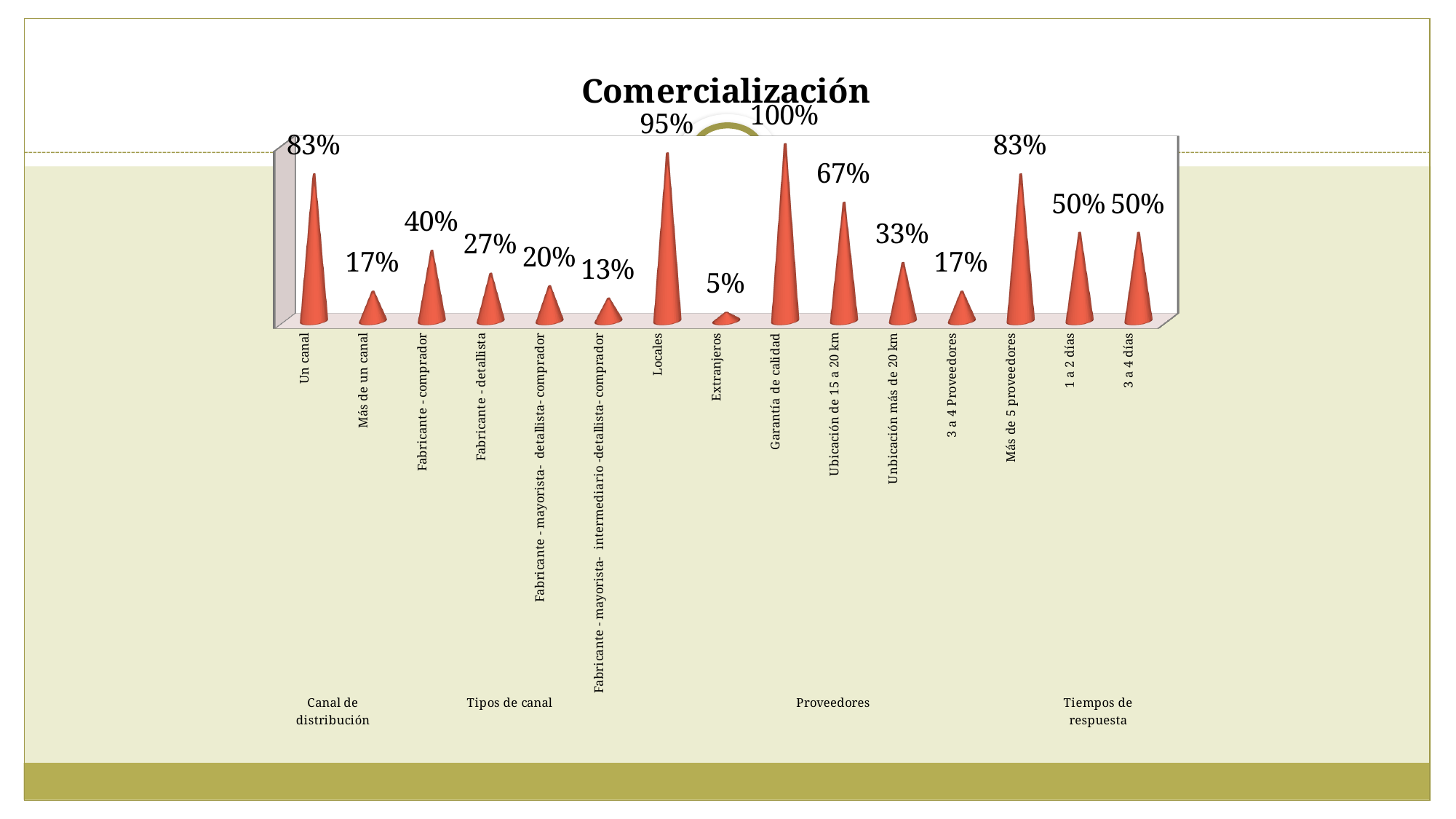
What is the value for Fabricante - detallista? 27% What is the title of the chart? Comercialización What kind of chart is shown? Bar chart Which is larger, the value for Fabricante - comprador or the value for Fabricante - detallista? Fabricante - comprador How many categories are plotted in the chart? 15 What is the difference between the values for Locales and Extranjeros? 90% What is the value for Locales? 95% Which category has the lowest value? Extranjeros What is the value for Un canal? 83% Which category has the highest value? Garantía de calidad What is the value for Ubicación de 15 a 20 km? 67% What is the difference between the values for Más de 5 proveedores and 3 a 4 Proveedores? 66%